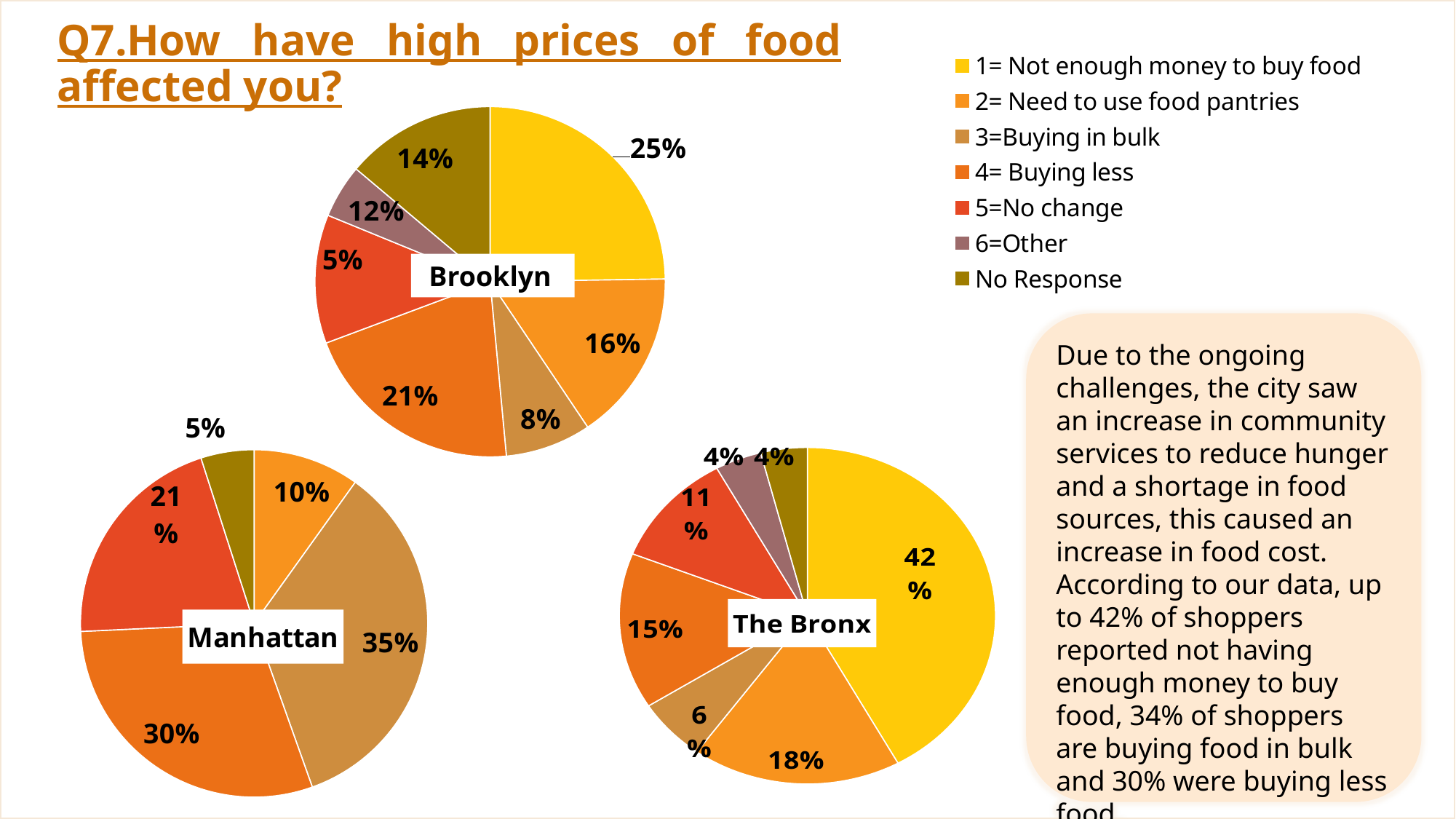
In the Brooklyn pie chart, what is the difference between the '1= Not enough money to buy food' slice and the '2= Need to use food pantries' slice? 9% In The Bronx pie chart, what percentage is shown for '2= Need to use food pantries'? 18% How many entries does the legend list? 7 What type of chart is used for Brooklyn, Manhattan and The Bronx? Pie chart In The Bronx pie chart, which category has the largest slice? 1= Not enough money to buy food In the Manhattan pie chart, what percentage is shown for '3=Buying in bulk'? 35% In the Brooklyn pie chart, which category has the smallest slice? 6=Other How many slices does the Manhattan pie chart have? 5 In the Brooklyn pie chart, what percentage is shown for '4= Buying less'? 21% In The Bronx pie chart, which is larger: '4= Buying less' or '5=No change'? 4= Buying less In the Brooklyn pie chart, what percentage is shown for '1= Not enough money to buy food'? 25% In the Manhattan pie chart, which category has the smallest slice? No Response